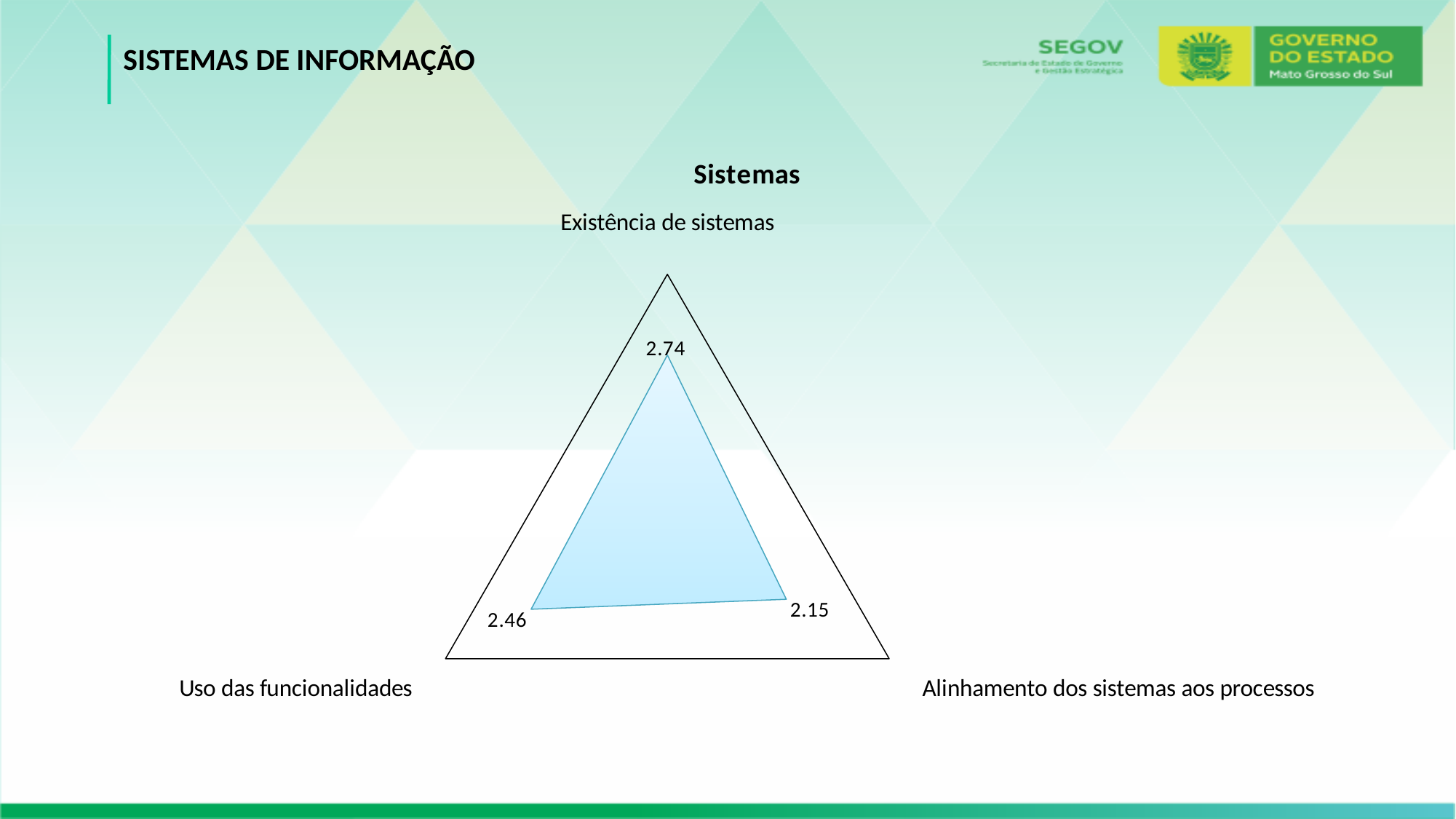
What kind of chart is shown on the slide? Radar chart How many categories (axes) does the chart have? 3 What is the value for Alinhamento dos sistemas aos processos? 2.15 What is the difference between the values for Existência de sistemas and Alinhamento dos sistemas aos processos? 0.59 Which category has the lowest value? Alinhamento dos sistemas aos processos What is the difference between the values for Existência de sistemas and Uso das funcionalidades? 0.28 What is the title of the chart? Sistemas Which category has the highest value? Existência de sistemas What is the difference between the values for Uso das funcionalidades and Alinhamento dos sistemas aos processos? 0.31 Which is larger, the value for Uso das funcionalidades or the value for Alinhamento dos sistemas aos processos? Uso das funcionalidades What is the value for Uso das funcionalidades? 2.46 What is the value for Existência de sistemas? 2.74